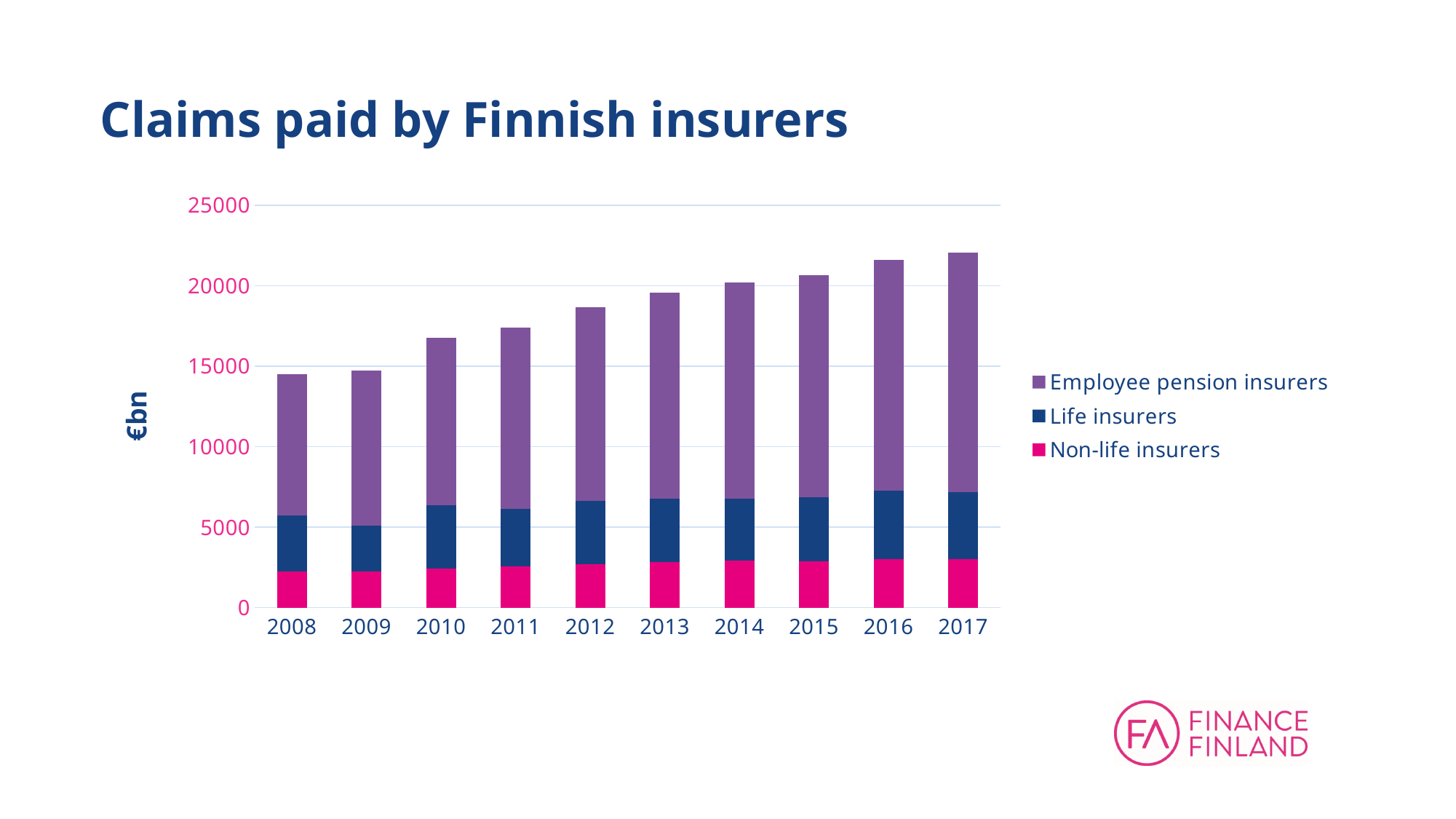
How many series does the legend list? 3 What is the label on the y axis of the chart? €bn Which is larger, the total claims paid in 2008 or in 2017? 2017 Is the value for Non-life insurers in 2017 greater or less than 5000? less Is the total claims paid in 2010 greater or less than 15000? greater Which series is shown in purple in the chart? Employee pension insurers Do total claims paid generally rise or fall from 2008 to 2017? Rise Which year has the highest total claims paid? 2017 Is the total claims paid in 2008 greater or less than 15000? less What kind of chart is shown on the slide? Stacked bar chart How many years are shown on the x axis of the chart? 10